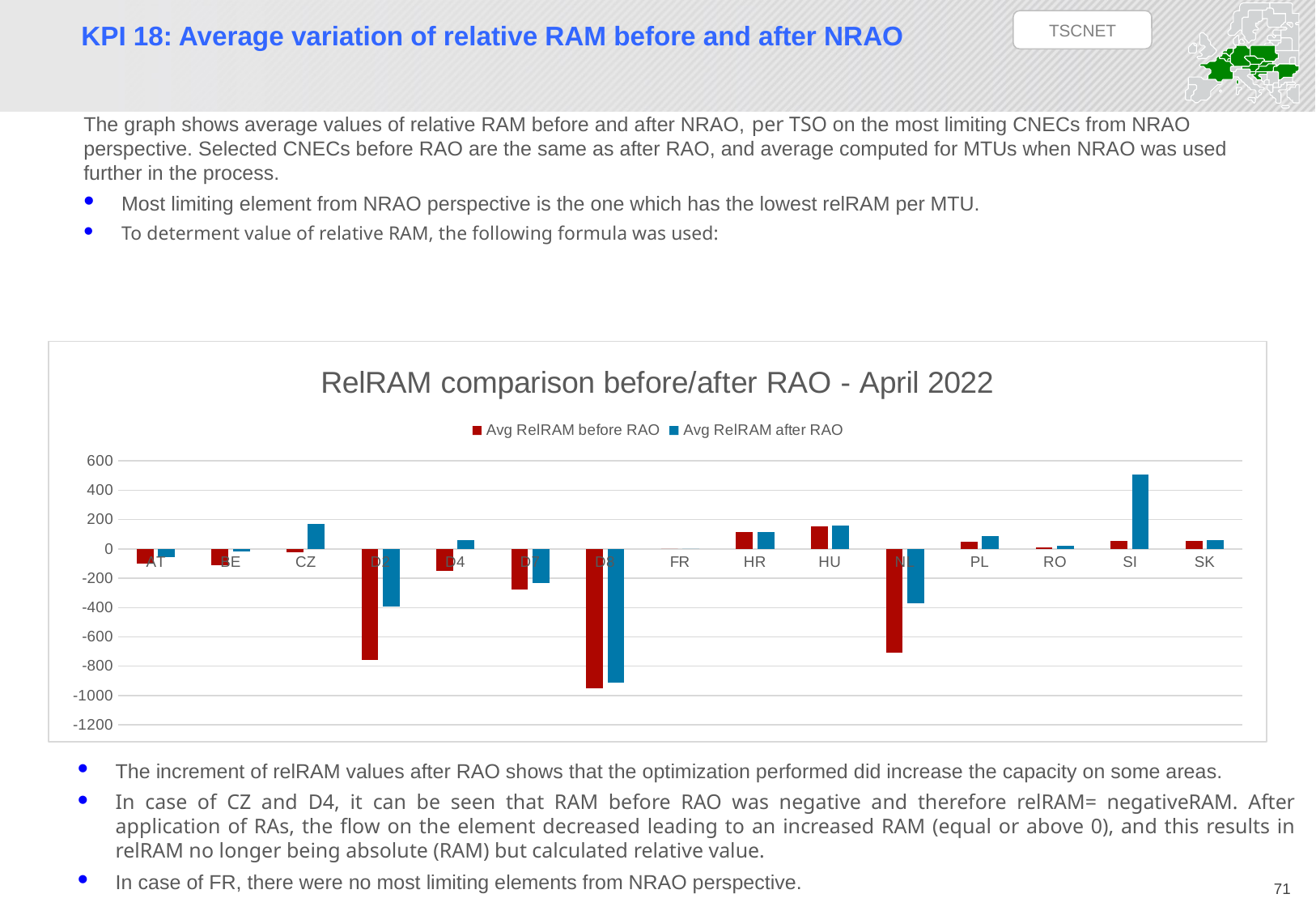
How many series does the legend of the chart list? 2 Is the value for Avg RelRAM after RAO for CZ greater or less than 100? greater What is the title of the chart? RelRAM comparison before/after RAO - April 2022 Is the value for Avg RelRAM after RAO for SI greater or less than 400? greater What kind of chart is shown on the slide? bar chart Which category has the larger value for Avg RelRAM after RAO: CZ or PL? CZ Which series is shown in red in the chart? Avg RelRAM before RAO How many categories are shown along the x axis of the chart? 15 Which category has the highest value for Avg RelRAM after RAO? SI Which is larger for SI: Avg RelRAM before RAO or Avg RelRAM after RAO? Avg RelRAM after RAO Is the value for Avg RelRAM before RAO for HU greater or less than 100? greater